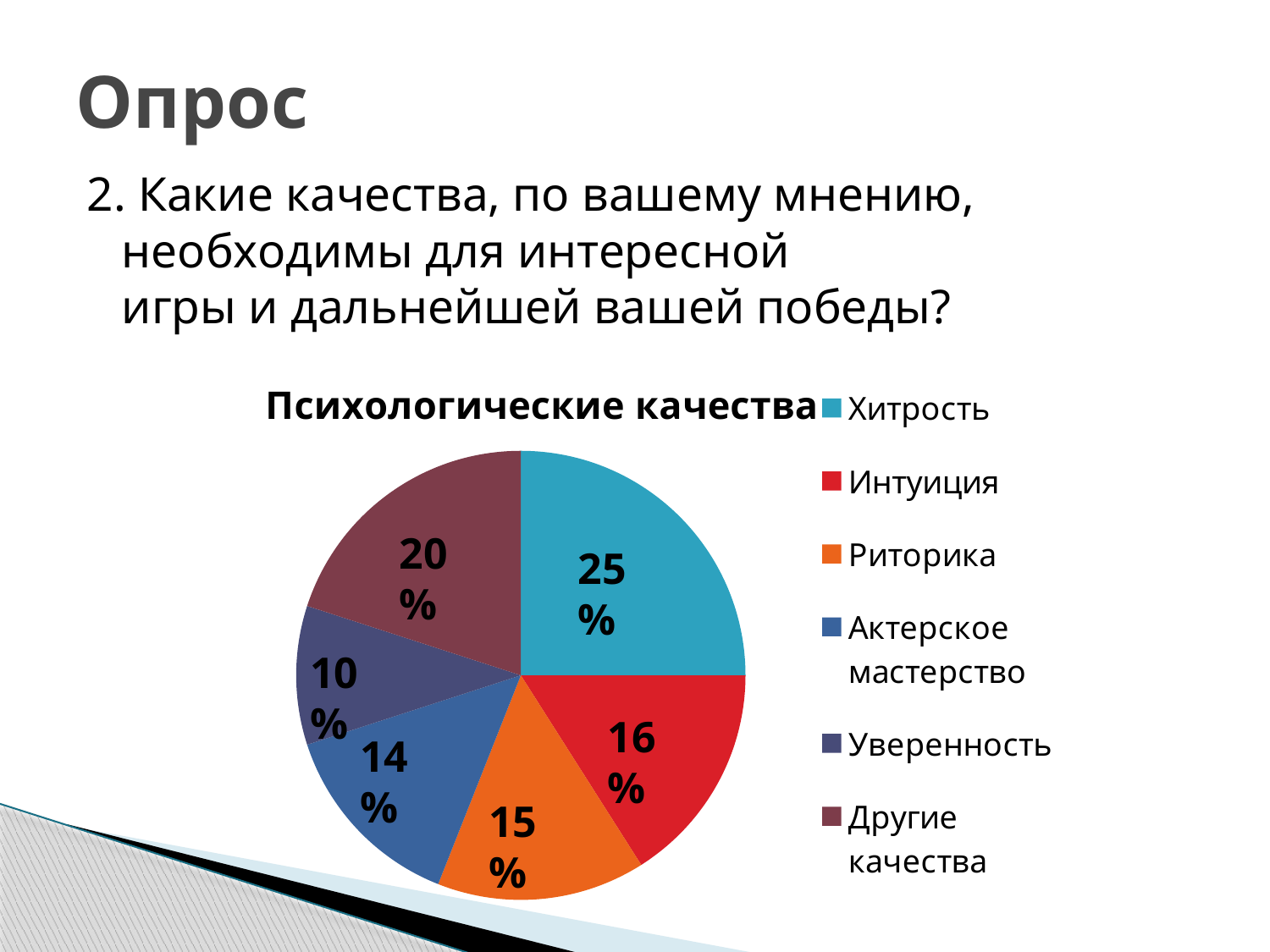
What is the difference in percentage points between Хитрость and Уверенность? 15 Which category has the largest slice of the pie? Хитрость What share of the pie does Риторика have? 15% What share of the pie does Интуиция have? 16% Which category has the smallest slice of the pie? Уверенность What share of the pie does Хитрость have? 25% What is the title of the chart? Психологические качества What share of the pie does Актерское мастерство have? 14% What share of the pie does Другие качества have? 20% How many categories does the pie chart have? 6 What share of the pie does Уверенность have? 10% What kind of chart is shown on the slide? Pie chart